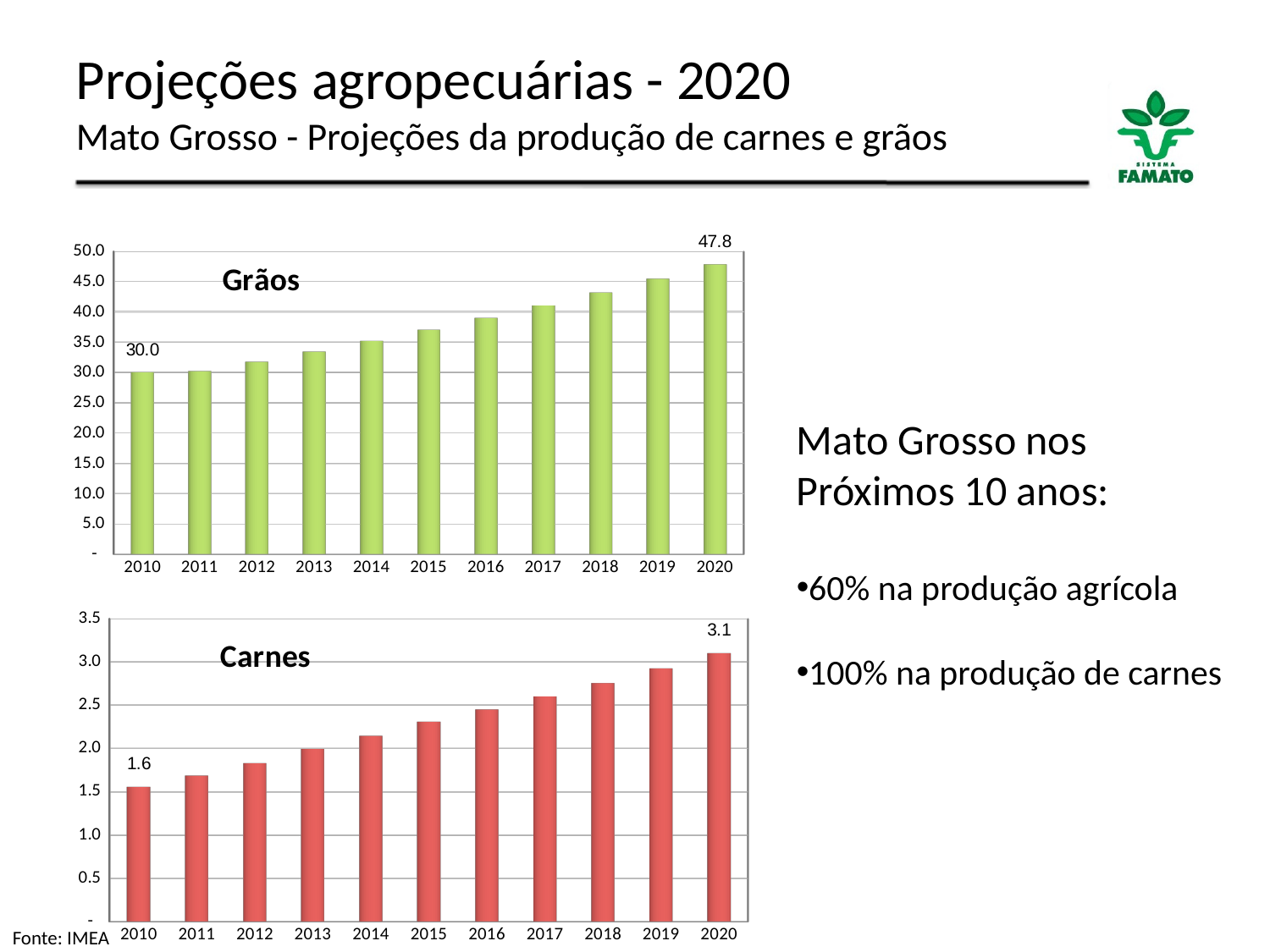
In the Carnes chart, what is the value for 2010? 1.6 In the Carnes chart, what is the difference between the 2020 and 2010 values? 1.5 In the Carnes chart, which year has the lowest value? 2010 In the Grãos chart, is the value for 2015 greater or less than 35.0? greater In the Grãos chart, which year has the highest value? 2020 In the Grãos chart, what is the value for 2020? 47.8 In the Carnes chart, is the value for 2014 greater or less than 2.5? less In the Carnes chart, what is the value for 2020? 3.1 How many years are shown in the Carnes chart? 11 In the Grãos chart, do the values rise or fall from 2010 to 2020? rise In the Grãos chart, what is the value for 2010? 30.0 In the Grãos chart, what is the difference between the 2020 and 2010 values? 17.8